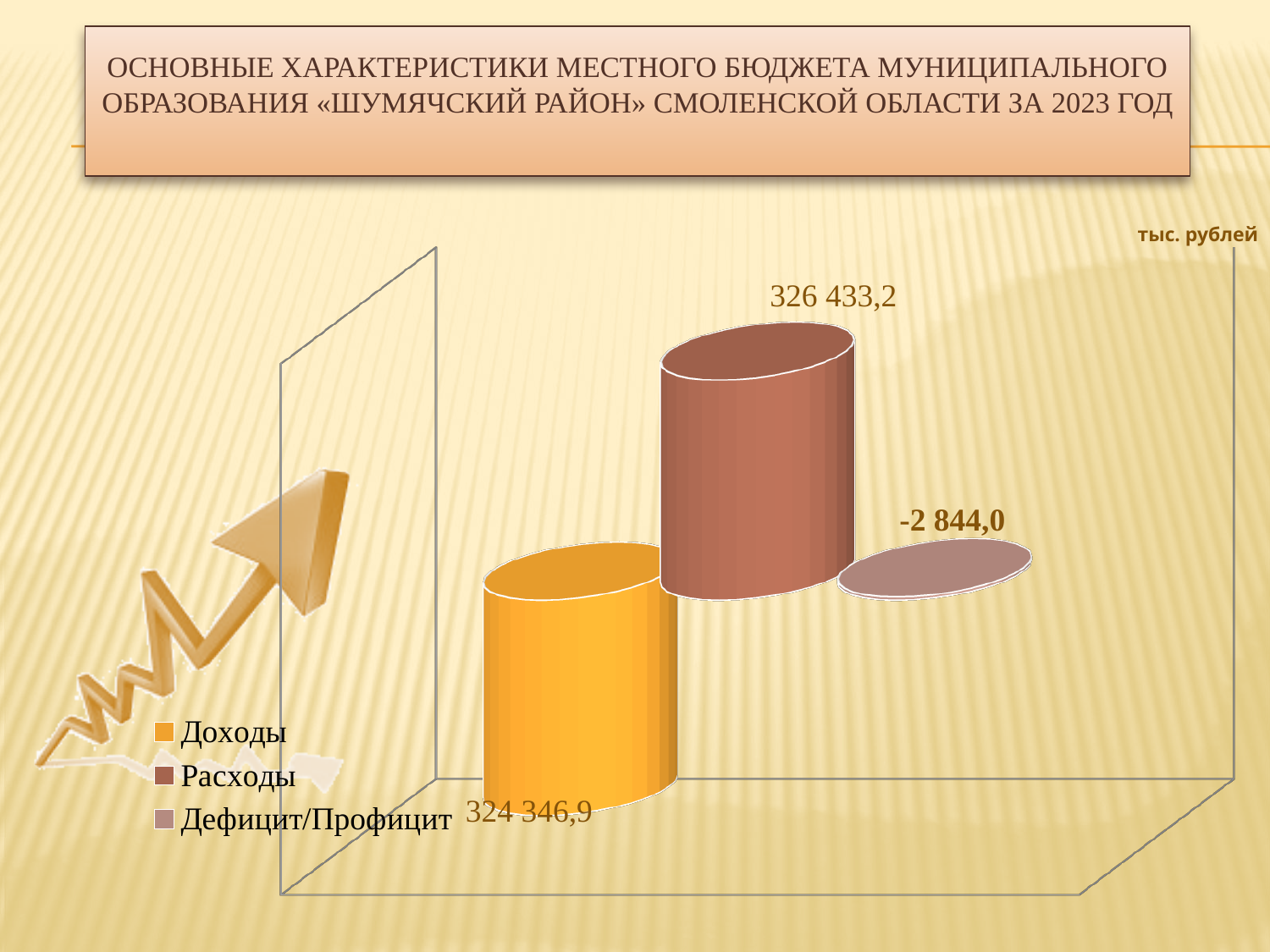
What colour is the bar for Доходы? orange What is the value for Доходы? 324 346,9 What unit is indicated for the chart values? тыс. рублей How many series does the legend list? 3 Which is larger, Доходы or Расходы? Расходы What is the value for Дефицит/Профицит? -2 844,0 Which series has the lowest value? Дефицит/Профицит Which series has the highest value? Расходы What is the difference between Расходы and Доходы? 2 086,3 What kind of chart is shown? bar chart How many bars are plotted on the chart? 3 What is the value for Расходы? 326 433,2